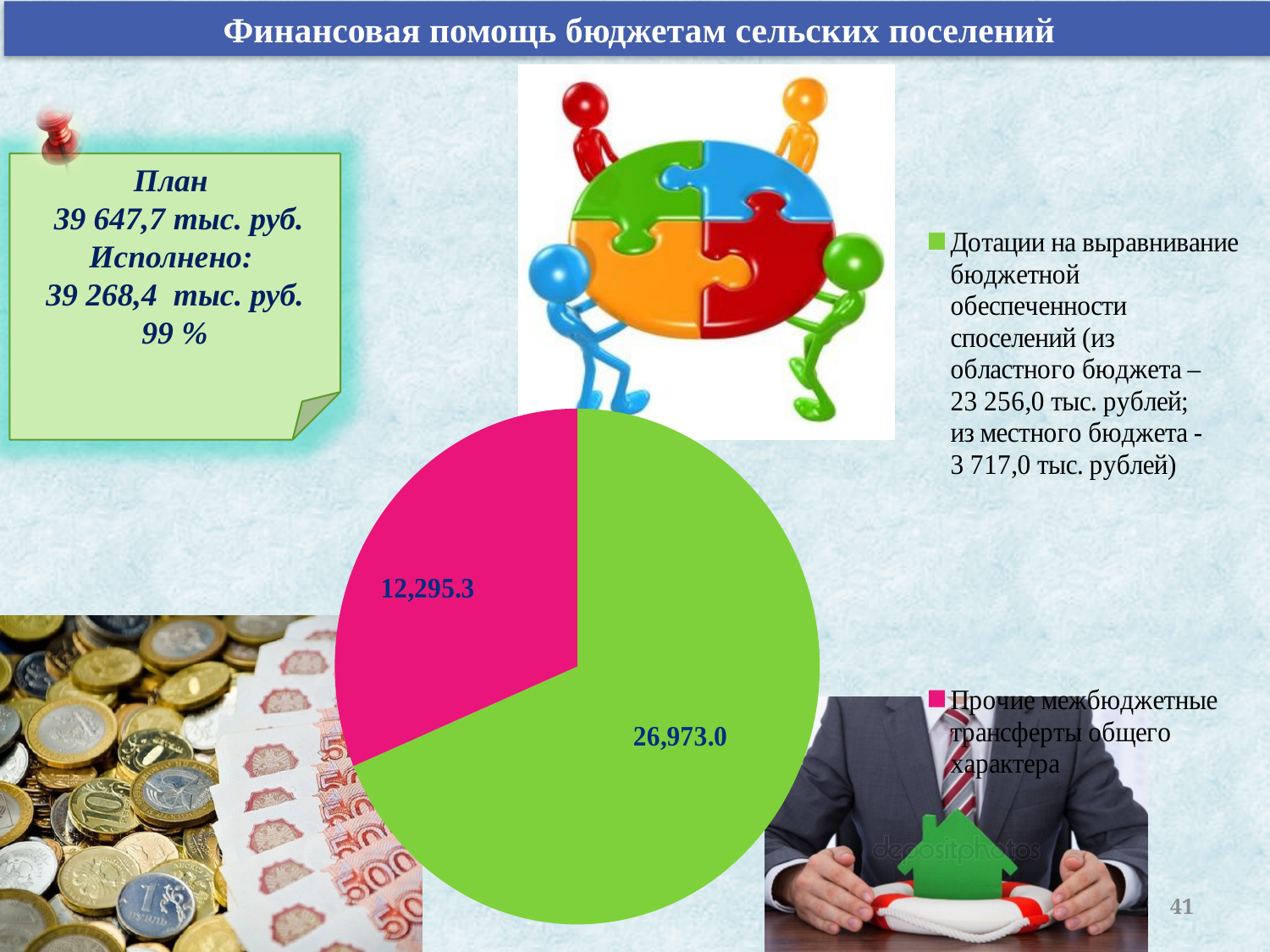
What is the total of the two values shown in the pie chart? 39,268.3 Which category has the smallest slice in the pie chart? Прочие межбюджетные трансферты общего характера Which category has the largest slice in the pie chart? Дотации на выравнивание бюджетной обеспеченности поселений What is the value for "Прочие межбюджетные трансферты общего характера" in the pie chart? 12,295.3 How many slices does the pie chart have? 2 What type of chart is shown on the slide? pie chart What colour is the slice for "Дотации на выравнивание бюджетной обеспеченности поселений"? green How many entries does the legend of the pie chart list? 2 What is the difference between the two values shown in the pie chart? 14,677.7 Which is larger: the slice for "Дотации на выравнивание бюджетной обеспеченности поселений" or the slice for "Прочие межбюджетные трансферты общего характера"? Дотации на выравнивание бюджетной обеспеченности поселений What is the value for "Дотации на выравнивание бюджетной обеспеченности поселений" in the pie chart? 26,973.0 What colour is the slice for "Прочие межбюджетные трансферты общего характера"? pink